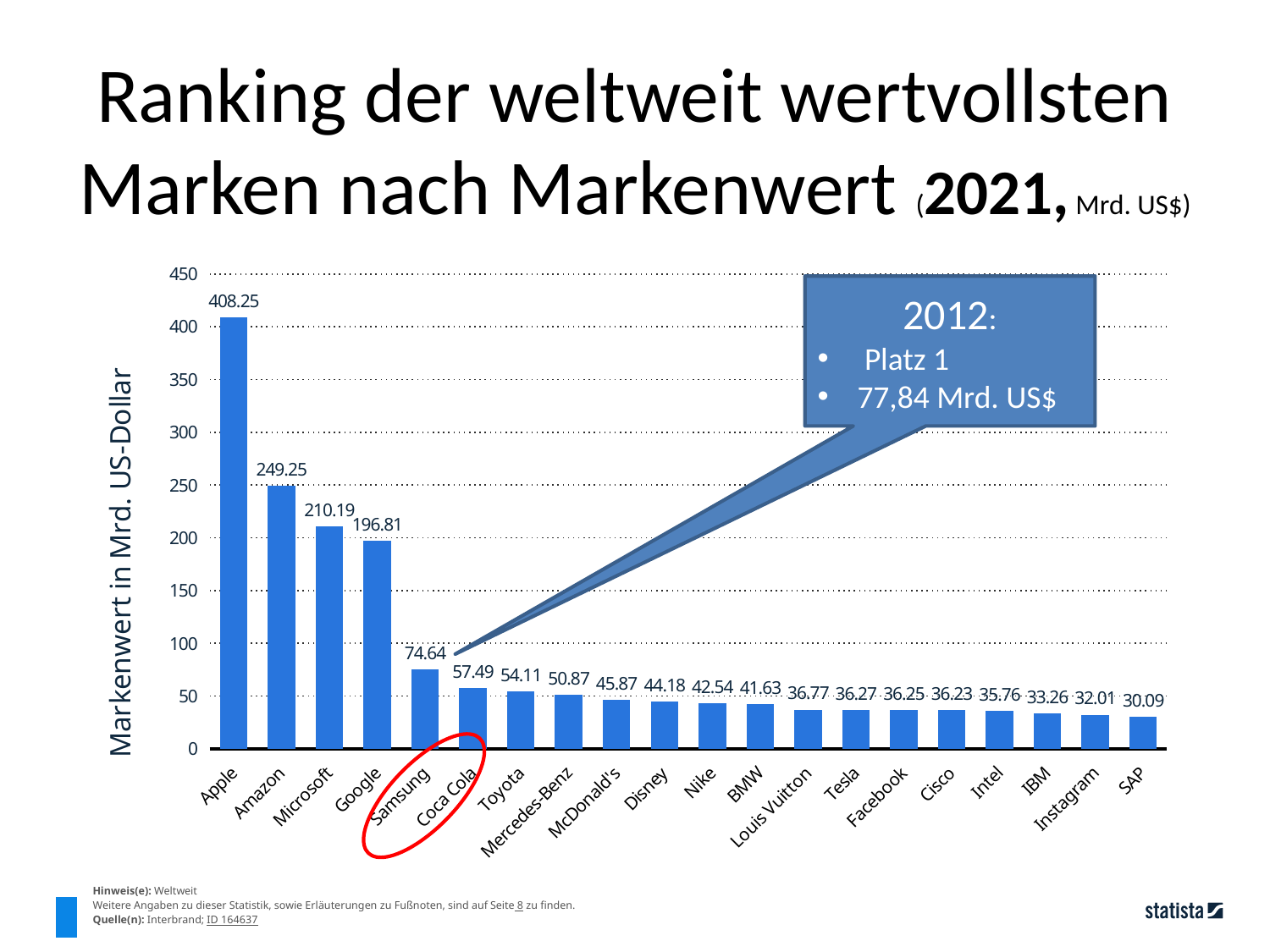
Which has a larger brand value, Microsoft or Google? Microsoft Which brand has the lowest brand value in the chart? SAP What is the brand value shown for Apple? 408.25 What is the brand value shown for Samsung? 74.64 What kind of chart is shown on the slide? bar chart How many brands are shown in the chart? 20 Do the brand values rise or fall from left to right along the x axis? fall What is the brand value shown for Tesla? 36.27 Which brand has the highest brand value in the chart? Apple Is the value for Amazon greater or less than 200? greater What is the difference between the brand values of Apple and Amazon? 159.00 What is the difference between the brand values of Samsung and Coca Cola? 17.15